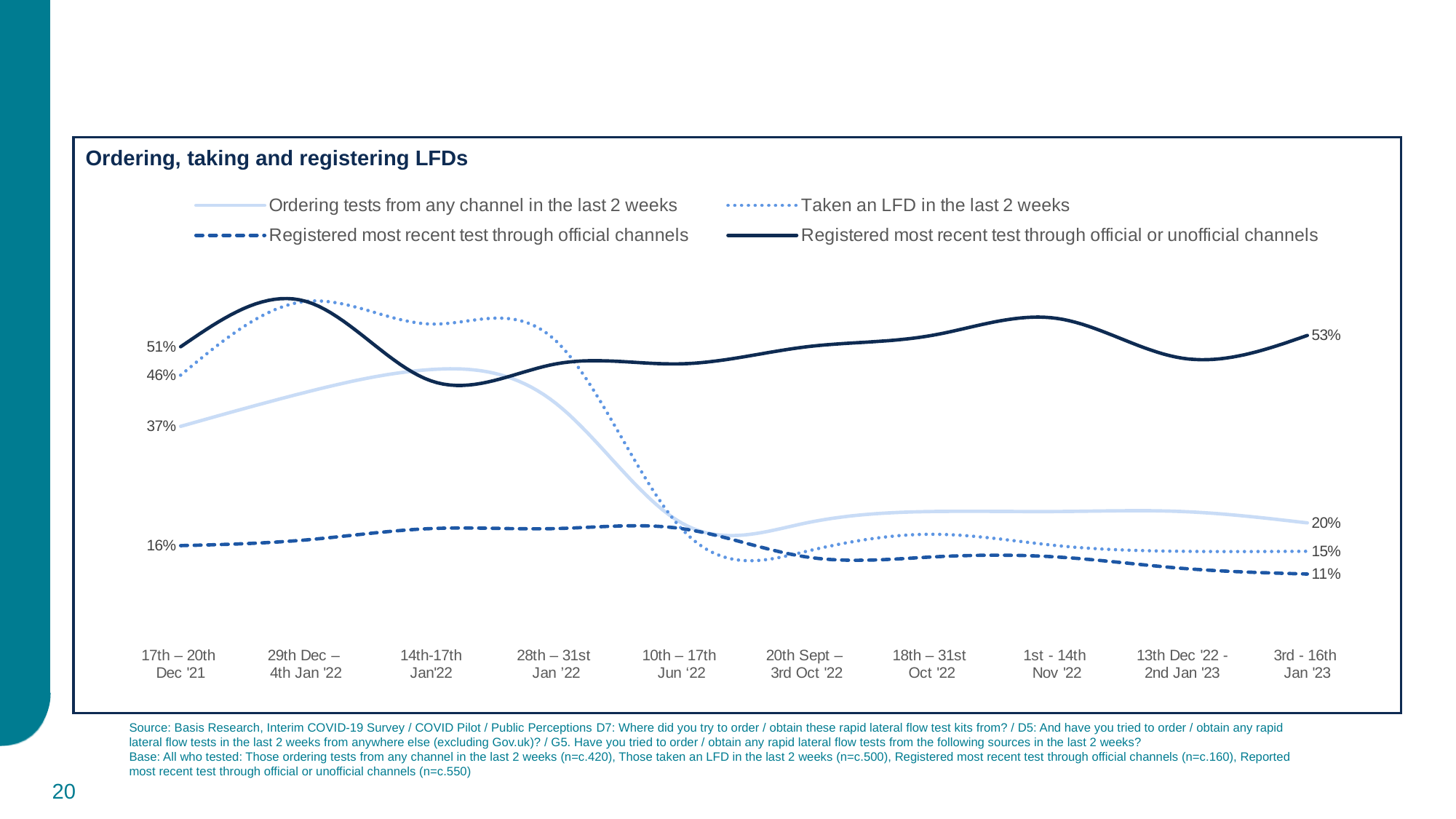
What is the value for 'Registered most recent test through official channels' in the 3rd - 16th Jan '23 period? 11% Which series has the lowest value in the 17th – 20th Dec '21 period? Registered most recent test through official channels What type of chart is shown on the slide? line chart What is the value for 'Taken an LFD in the last 2 weeks' in the 17th – 20th Dec '21 period? 46% What is the value for 'Registered most recent test through official or unofficial channels' in the 17th – 20th Dec '21 period? 51% What is the value for 'Ordering tests from any channel in the last 2 weeks' in the 3rd - 16th Jan '23 period? 20% How many series does the legend list? 4 Which series has the highest value in the 3rd - 16th Jan '23 period? Registered most recent test through official or unofficial channels What is the difference between the 'Ordering tests from any channel in the last 2 weeks' values in the 17th – 20th Dec '21 and 3rd - 16th Jan '23 periods? 17 percentage points What is the title of the chart? Ordering, taking and registering LFDs Which is larger in the 3rd - 16th Jan '23 period: 'Taken an LFD in the last 2 weeks' or 'Registered most recent test through official channels'? Taken an LFD in the last 2 weeks How many time periods are shown on the x axis? 10